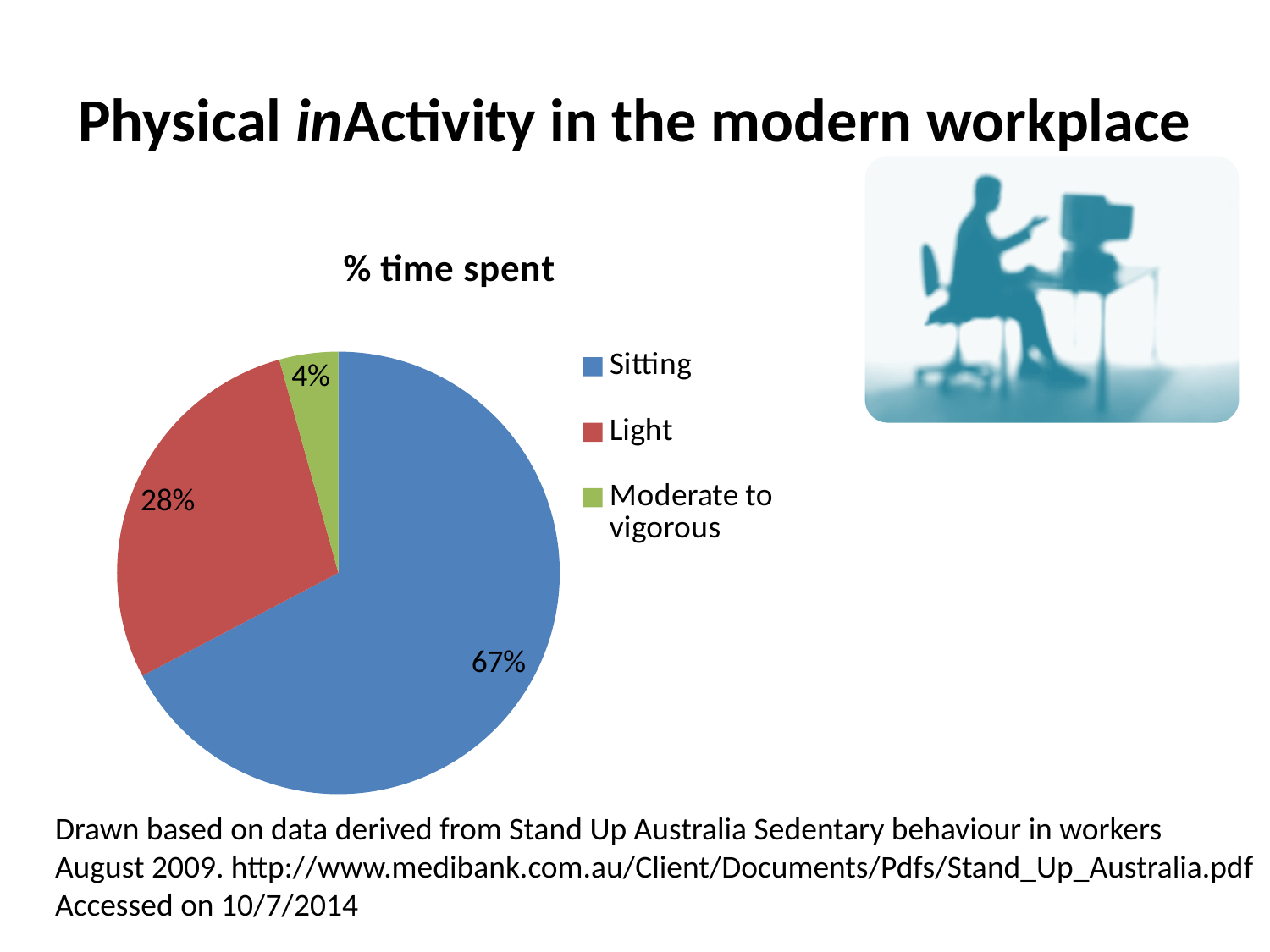
What percentage of time is spent in Light activity? 28% How many categories does the pie chart show? 3 What is the difference in percentage points between Sitting and Light? 39 What is the difference in percentage points between Light and Moderate to vigorous? 24 What is the title of the chart? % time spent What colour is the Sitting slice? blue Which is larger, the share for Light or the share for Moderate to vigorous? Light What kind of chart is shown on the slide? pie chart What percentage of time is spent Sitting? 67% Which category has the smallest share of time spent? Moderate to vigorous What percentage of time is spent in Moderate to vigorous activity? 4% Which category has the largest share of time spent? Sitting